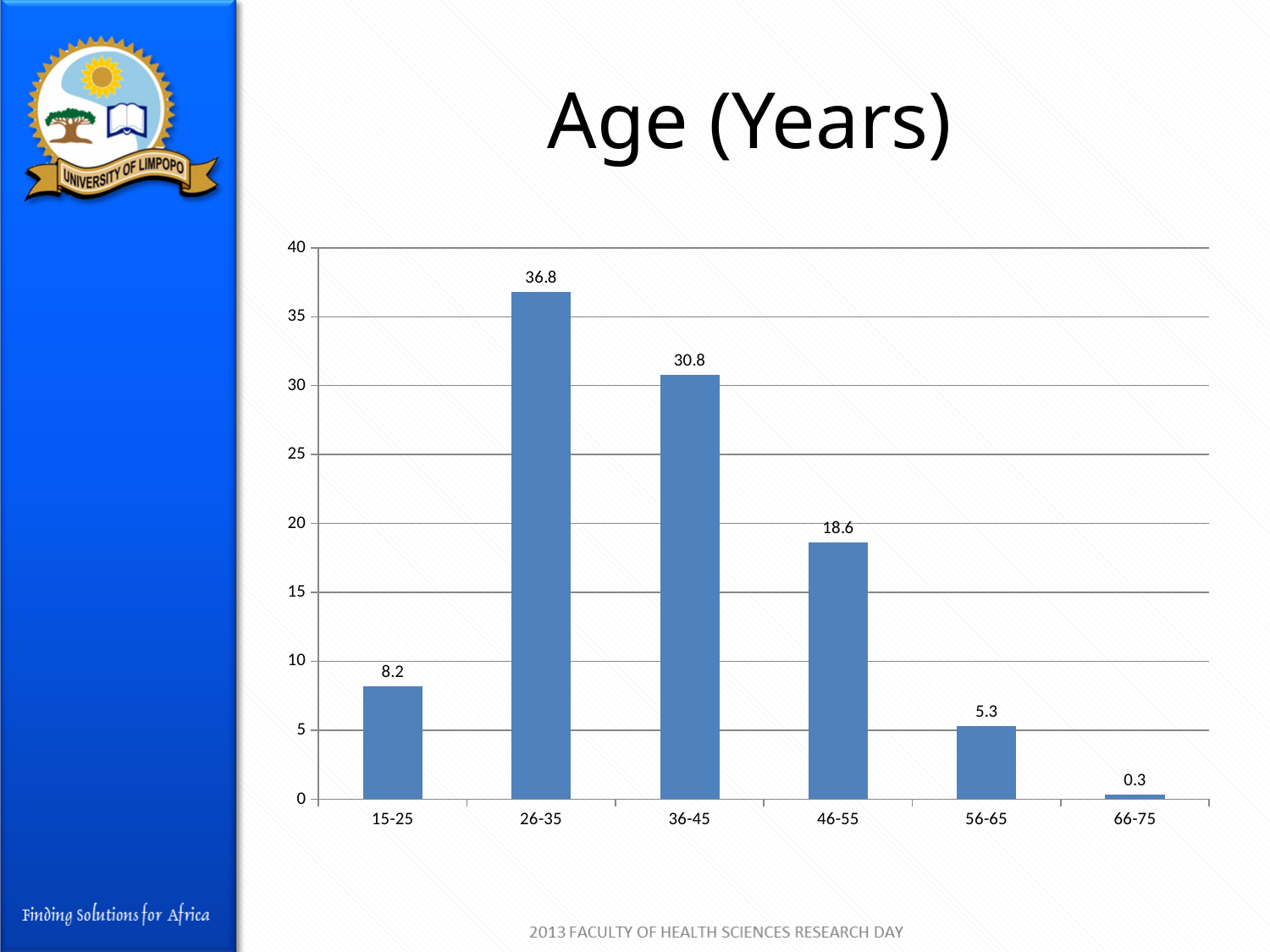
How many age groups are shown on the x axis? 6 What is the difference between the values for the 15-25 and 56-65 age groups? 2.9 What is the title of the chart? Age (Years) Which age group has the lowest value? 66-75 Which age group has the highest value? 26-35 What kind of chart is shown on the slide? bar chart What is the value for the 46-55 age group? 18.6 Is the value for the 36-45 age group greater or less than 30? greater What is the value for the 26-35 age group? 36.8 What is the difference between the values for the 26-35 and 36-45 age groups? 6 What is the value for the 66-75 age group? 0.3 Which is larger, the value for 15-25 or the value for 56-65? 15-25